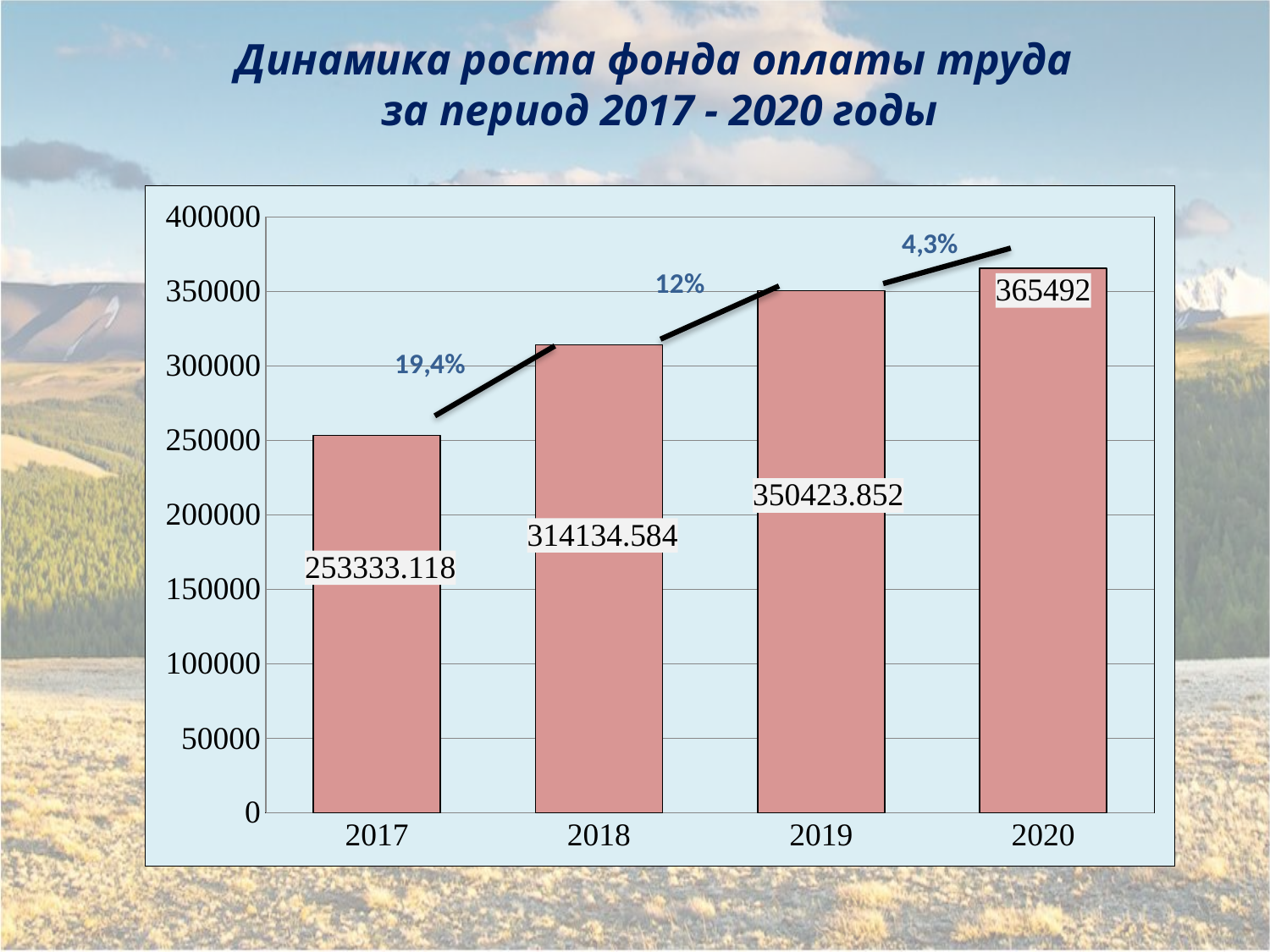
What kind of chart is this? bar chart What is the value for 2019? 350423.852 Do the values rise or fall from 2017 to 2020? rise What is the value for 2017? 253333.118 How many years are shown on the x axis? 4 What is the value for 2020? 365492 Which year has the highest value? 2020 What is the value for 2018? 314134.584 What is the difference between the values for 2020 and 2019? 15068.148 What is the difference between the values for 2018 and 2017? 60801.466 Which year has the lowest value? 2017 Which is larger, the value for 2018 or the value for 2019? 2019